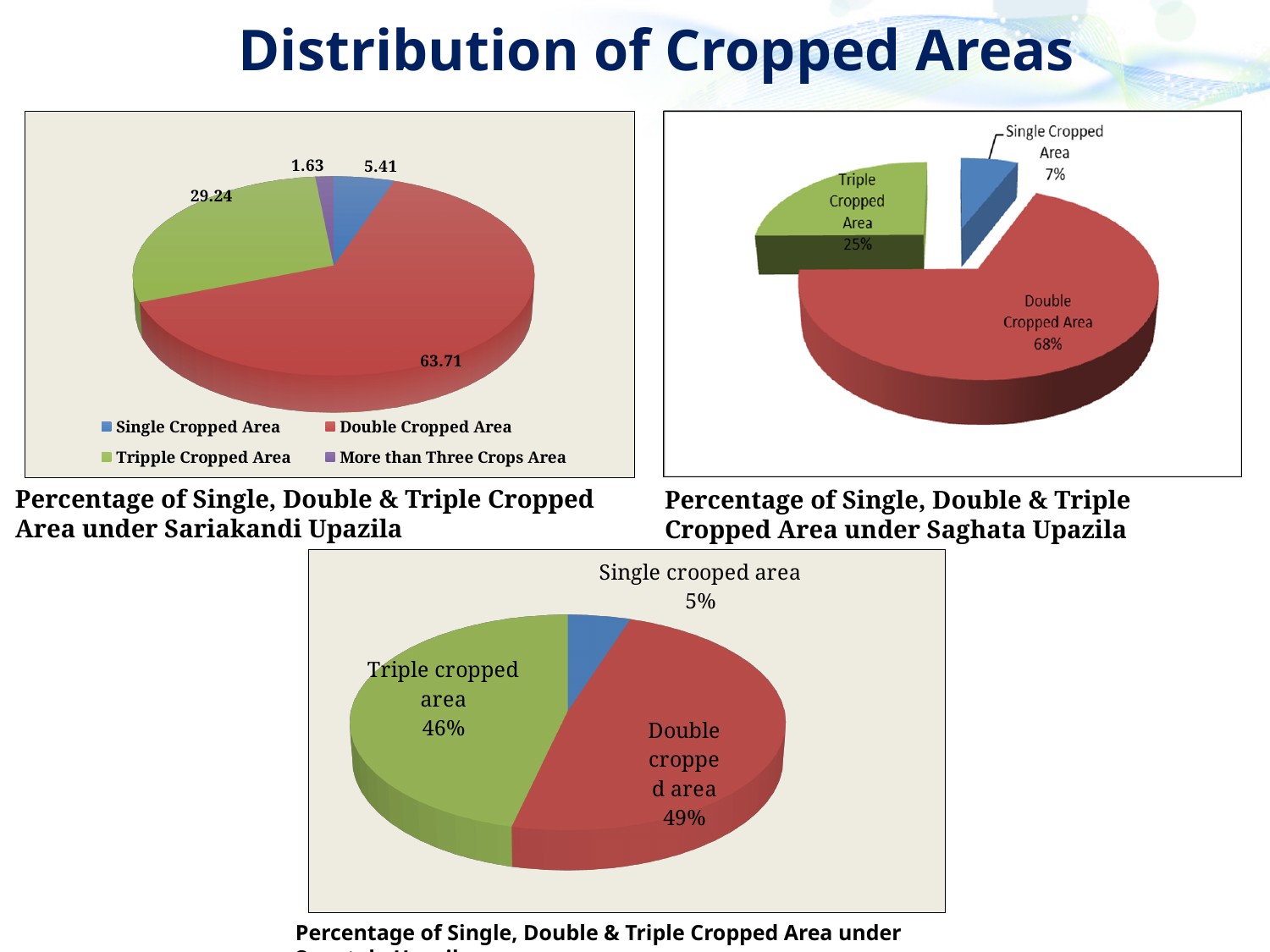
In the Sariakandi Upazila pie chart, what is the value for Double Cropped Area? 63.71 In the Sariakandi Upazila pie chart, which category has the smallest slice? More than Three Crops Area How many categories does the legend of the Sariakandi Upazila pie chart list? 4 How many slices does the bottom pie chart have? 3 In the Sariakandi Upazila pie chart, what is the value for More than Three Crops Area? 1.63 In the Saghata Upazila pie chart, which category has the largest share? Double Cropped Area In the Saghata Upazila pie chart, what is the difference between Double Cropped Area and Single Cropped Area? 61% What type of chart is used for the Saghata Upazila data? Pie chart In the bottom pie chart, which is larger, Double cropped area or Triple cropped area? Double cropped area In the Saghata Upazila pie chart, what percentage is Triple Cropped Area? 25% In the Sariakandi Upazila pie chart, what is the difference between the Double Cropped Area and Tripple Cropped Area values? 34.47 In the bottom pie chart, what percentage is Triple cropped area? 46%